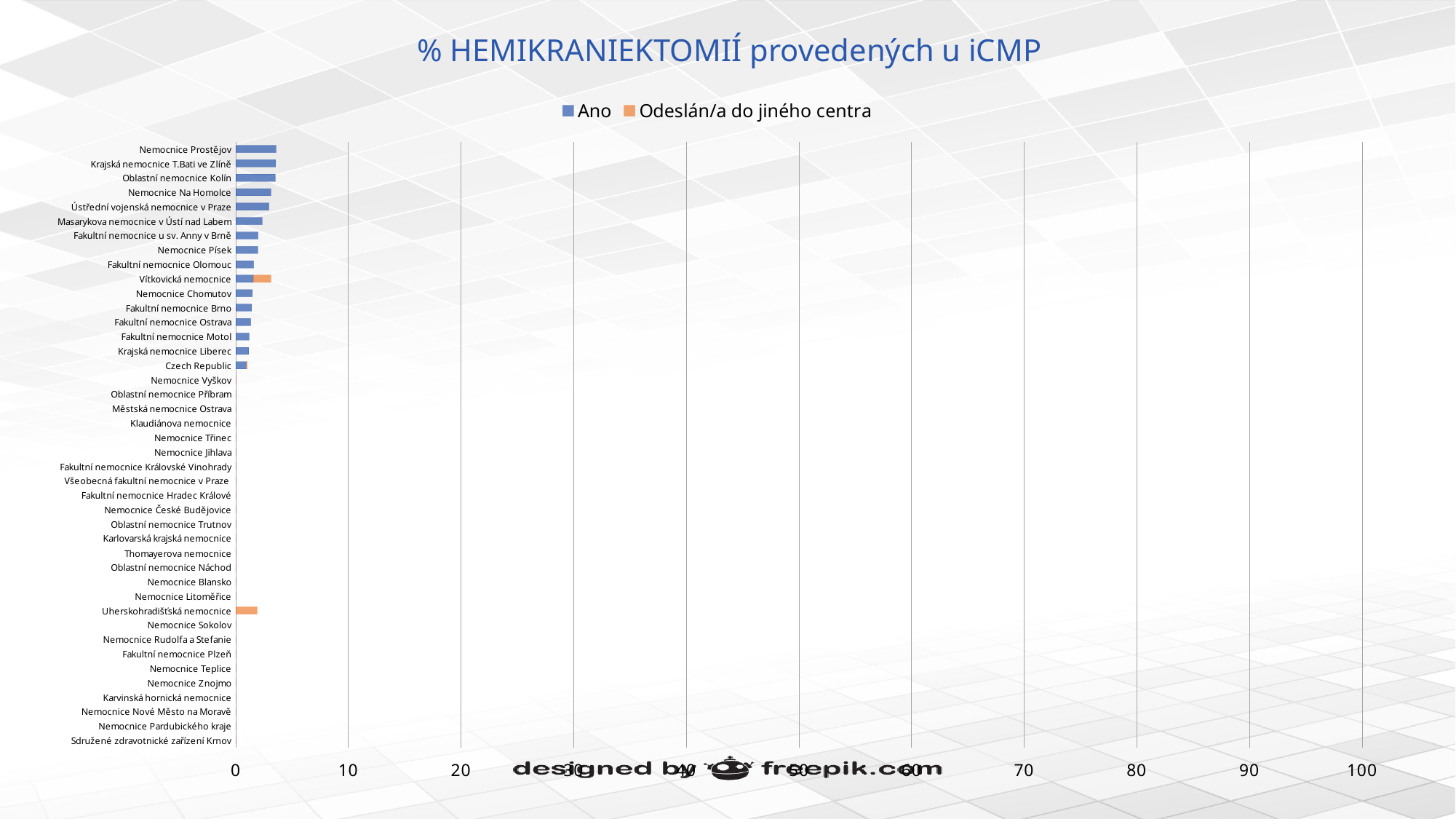
Which is larger, the Ano value for Nemocnice Prostějov or for Krajská nemocnice Liberec? Nemocnice Prostějov How many series does the legend list? 2 Which is larger, the Ano value for Nemocnice Na Homolce or for Fakultní nemocnice Motol? Nemocnice Na Homolce Is the value for Nemocnice Prostějov greater or less than 10? less What are the two series named in the legend? Ano; Odeslán/a do jiného centra Which hospital has a bar only for the series 'Odeslán/a do jiného centra' and none for 'Ano'? Uherskohradišťská nemocnice Is the value for Uherskohradišťská nemocnice greater or less than 10? less What is the maximum value shown on the horizontal axis? 100 What is the title of the chart? % HEMIKRANIEKTOMIÍ provedených u iCMP What kind of chart is shown on the slide? bar chart How many hospitals/categories are listed on the vertical axis? 42